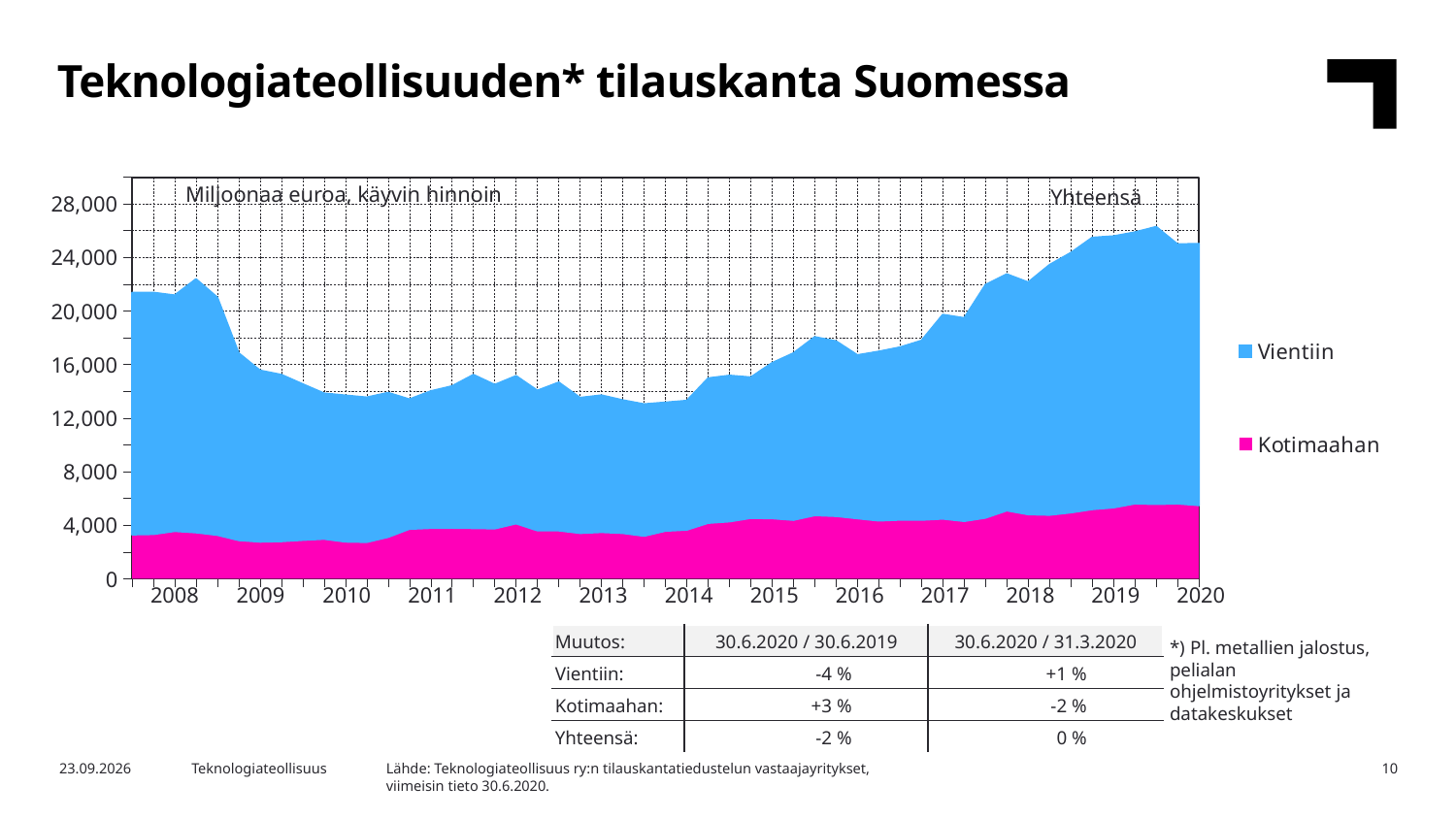
Does the total order book (Yhteensä) rise or fall between 2014 and 2019? rise What unit label is shown at the top left of the chart area? Miljoonaa euroa, käyvin hinnoin Does the total order book (Yhteensä) rise or fall between 2008 and 2009? fall Is the total (Yhteensä) value in 2013 greater or less than 16,000? less What kind of chart is shown on the slide? Area chart Is the total (Yhteensä) value at 2020 greater or less than 24,000? greater Is the total (Yhteensä) value at the start of 2008 greater or less than 20,000? greater Which two series are listed in the chart legend? Vientiin and Kotimaahan How many year labels are shown on the x axis? 13 At 2020, which series is larger, Vientiin or Kotimaahan? Vientiin How many series does the legend list? 2